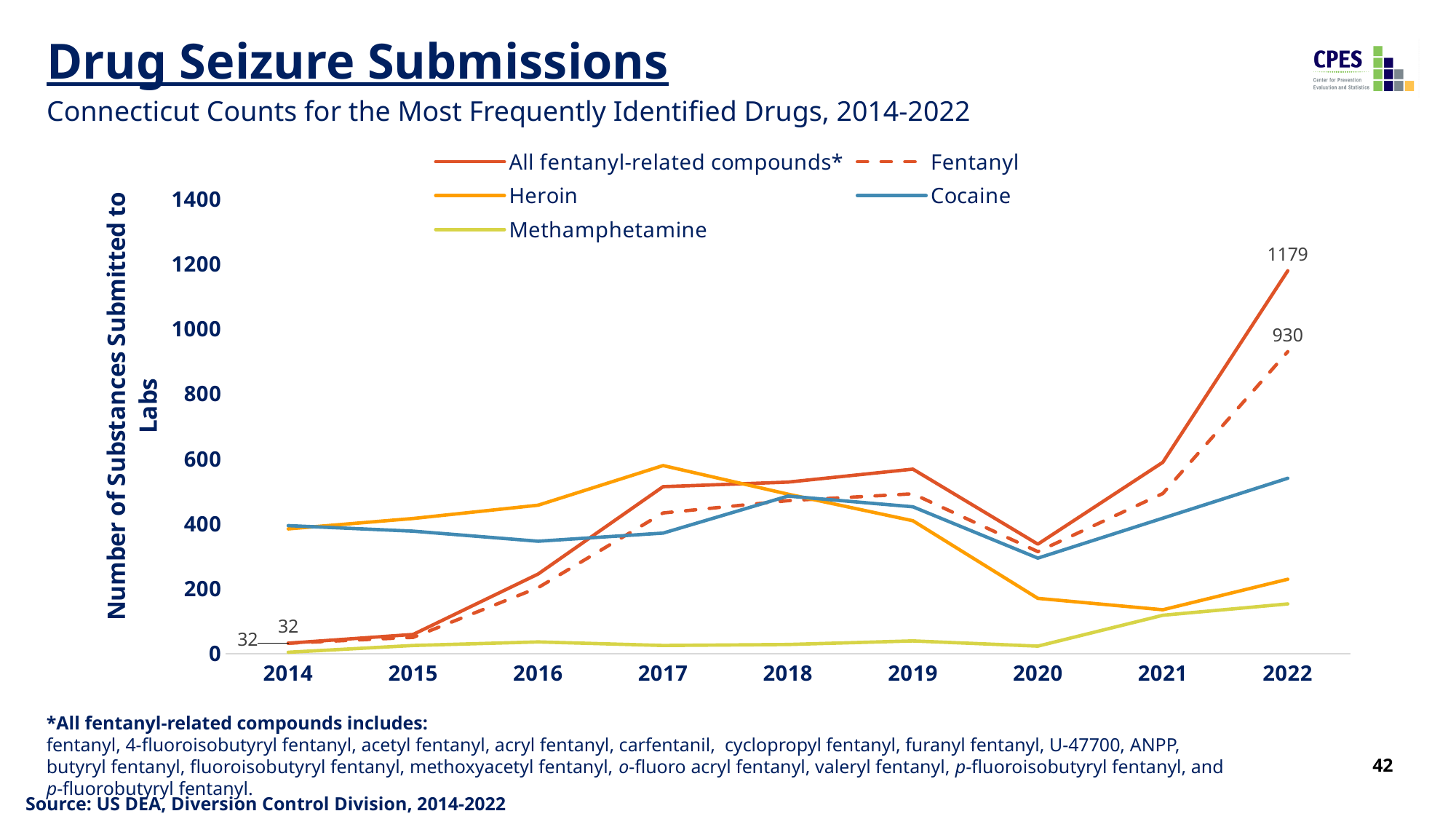
How many series does the legend list? 5 What kind of chart is shown on the slide? line chart What is the difference between All fentanyl-related compounds and Fentanyl in 2022? 249 Which series has the lowest value in 2022? Methamphetamine What is the value for All fentanyl-related compounds in 2014? 32 What is the value for All fentanyl-related compounds in 2022? 1179 Does the Heroin line rise or fall from 2017 to 2020? fall How many years are shown on the x axis? 9 Which is larger in 2020, Heroin or Cocaine? Cocaine Which series has the highest value in 2022? All fentanyl-related compounds* Is the value for Heroin in 2017 greater or less than 400? greater What is the value for Fentanyl in 2022? 930